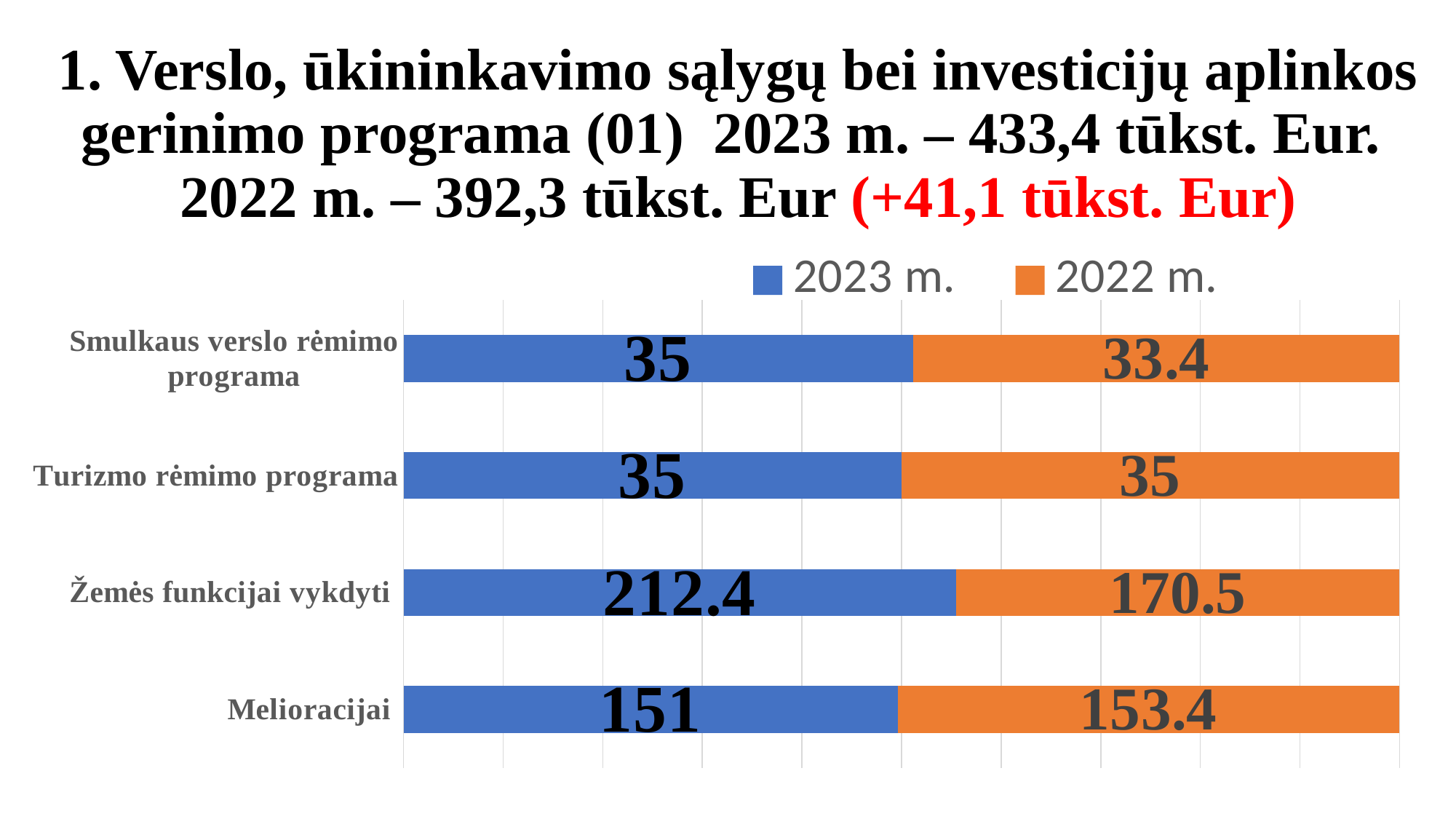
Which category has the highest 2023 m. value? Žemės funkcijai vykdyti For Melioracijai, which is larger: the 2023 m. value or the 2022 m. value? 2022 m. What is the 2022 m. value for Smulkaus verslo rėmimo programa? 33.4 What is the 2022 m. value for Melioracijai? 153.4 What kind of chart is shown on the slide? Stacked bar chart How many series does the legend list? 2 What is the 2023 m. value for Žemės funkcijai vykdyti? 212.4 Which colour represents the 2022 m. series? Orange How many categories are shown in the chart? 4 Which category has the lowest 2022 m. value? Smulkaus verslo rėmimo programa What is the 2023 m. value for Turizmo rėmimo programa? 35 What is the difference between the 2023 m. and 2022 m. values for Žemės funkcijai vykdyti? 41.9